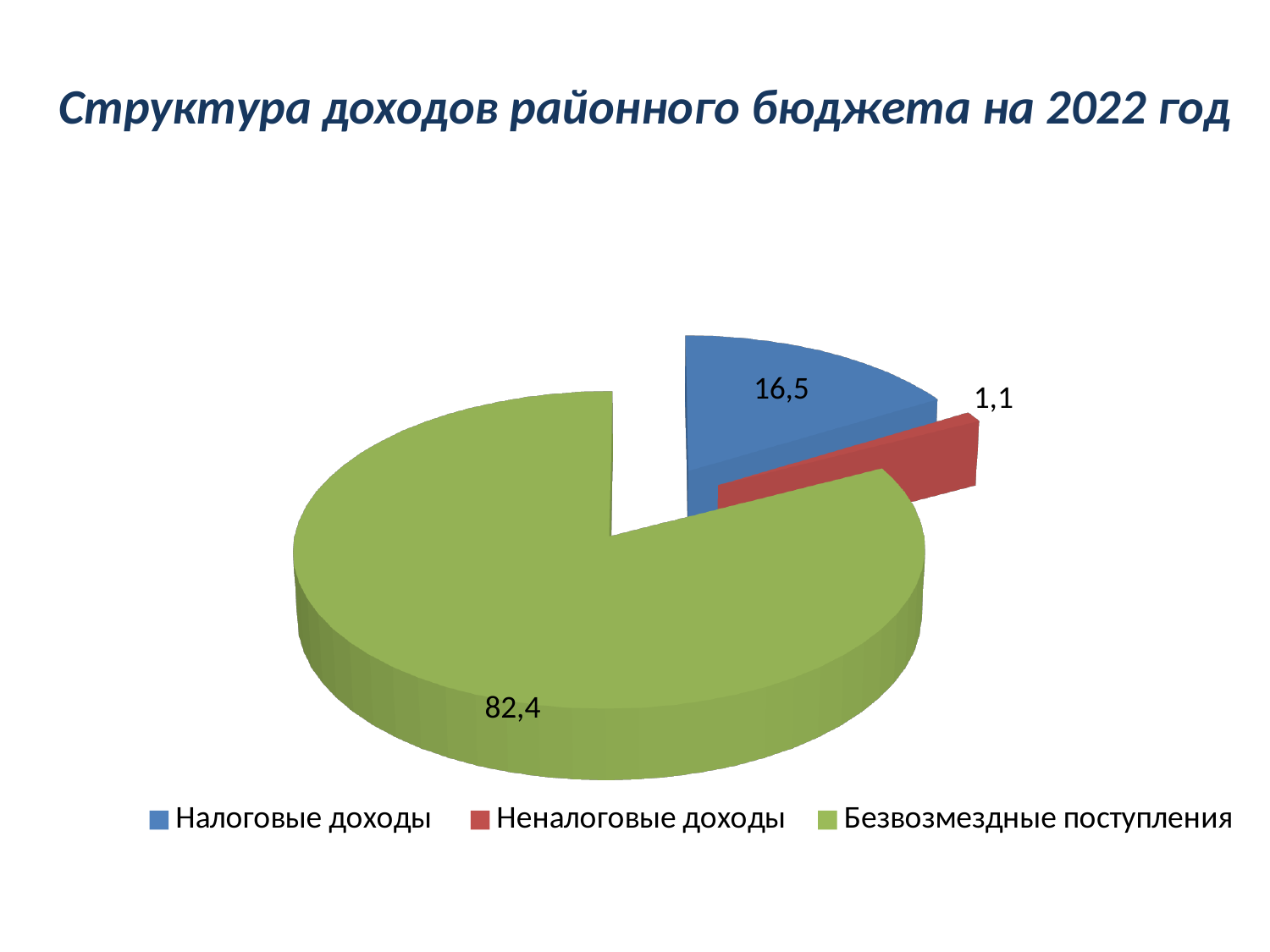
What is the difference between the values for Налоговые доходы and Неналоговые доходы? 15,4 What is the value for Налоговые доходы? 16,5 Which colour represents Безвозмездные поступления in the legend? Green What is the value for Неналоговые доходы? 1,1 What kind of chart is shown on the slide? Pie chart How many categories does the pie chart show? 3 What is the value for Безвозмездные поступления? 82,4 What is the title of the chart? Структура доходов районного бюджета на 2022 год Which category has the smallest slice of the pie? Неналоговые доходы What is the difference between the values for Безвозмездные поступления and Налоговые доходы? 65,9 Which is larger, Налоговые доходы or Неналоговые доходы? Налоговые доходы Which category has the largest slice of the pie? Безвозмездные поступления